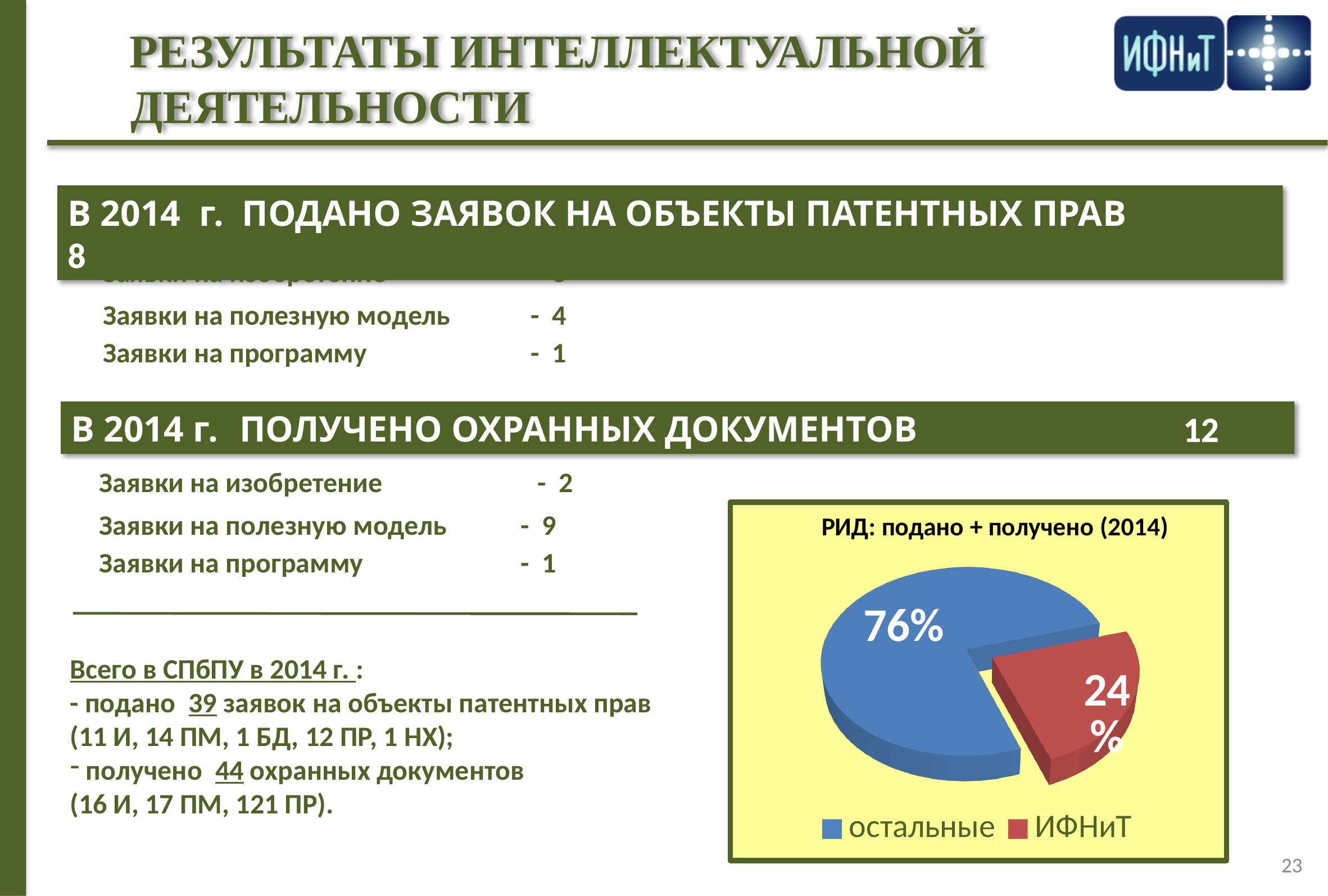
What kind of chart is shown on the slide? pie chart What share of the pie does the slice for остальные represent? 76% How many slices does the pie chart have? 2 What is the difference in percentage points between the остальные slice and the ИФНиТ slice? 52 How many entries does the legend of the pie chart list? 2 What colour is the ИФНиТ slice in the pie chart? red Is the share for ИФНиТ greater or less than 50%? less Which slice of the pie chart is the smallest? ИФНиТ What share of the pie does the slice for ИФНиТ represent? 24% Which slice of the pie chart is the largest? остальные Which is larger in the pie chart, the share for ИФНиТ or the share for остальные? остальные What is the title of the pie chart? РИД: подано + получено (2014)